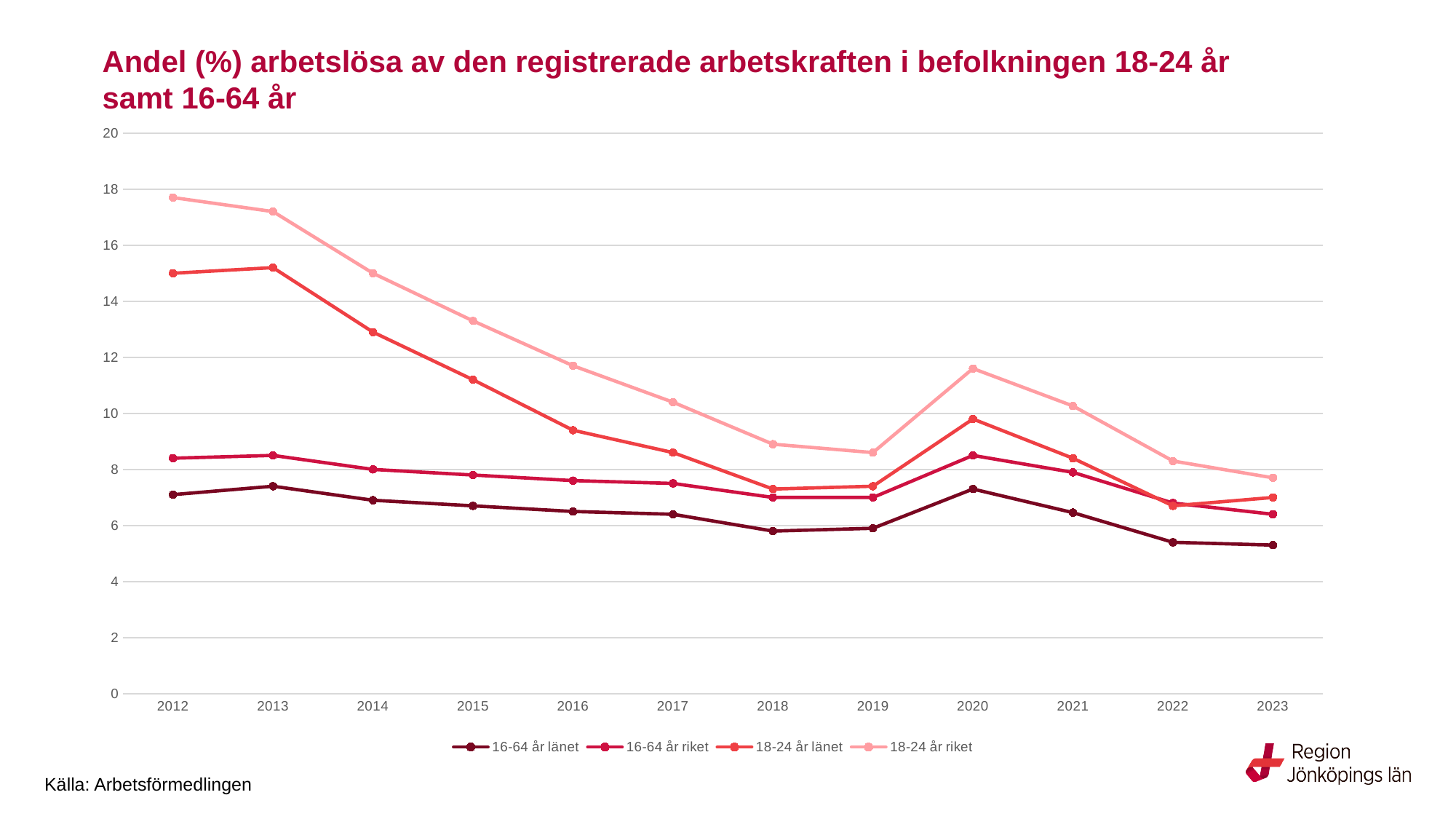
In which year does the 18-24 år riket series reach its highest value? 2012 Is the value for 18-24 år riket in 2020 greater or less than 10? greater How many years are plotted along the x axis? 12 Which series has the lowest value in 2023? 16-64 år länet Is the value for 18-24 år riket in 2012 greater or less than 16? greater In 2020, which is larger: 18-24 år länet or 16-64 år riket? 18-24 år länet Is the value for 16-64 år länet in 2023 greater or less than 6? less Does the 18-24 år riket series rise or fall from 2012 to 2019? fall How many series does the legend list? 4 Which series has the highest value in 2012? 18-24 år riket What kind of chart is shown on the slide? line chart